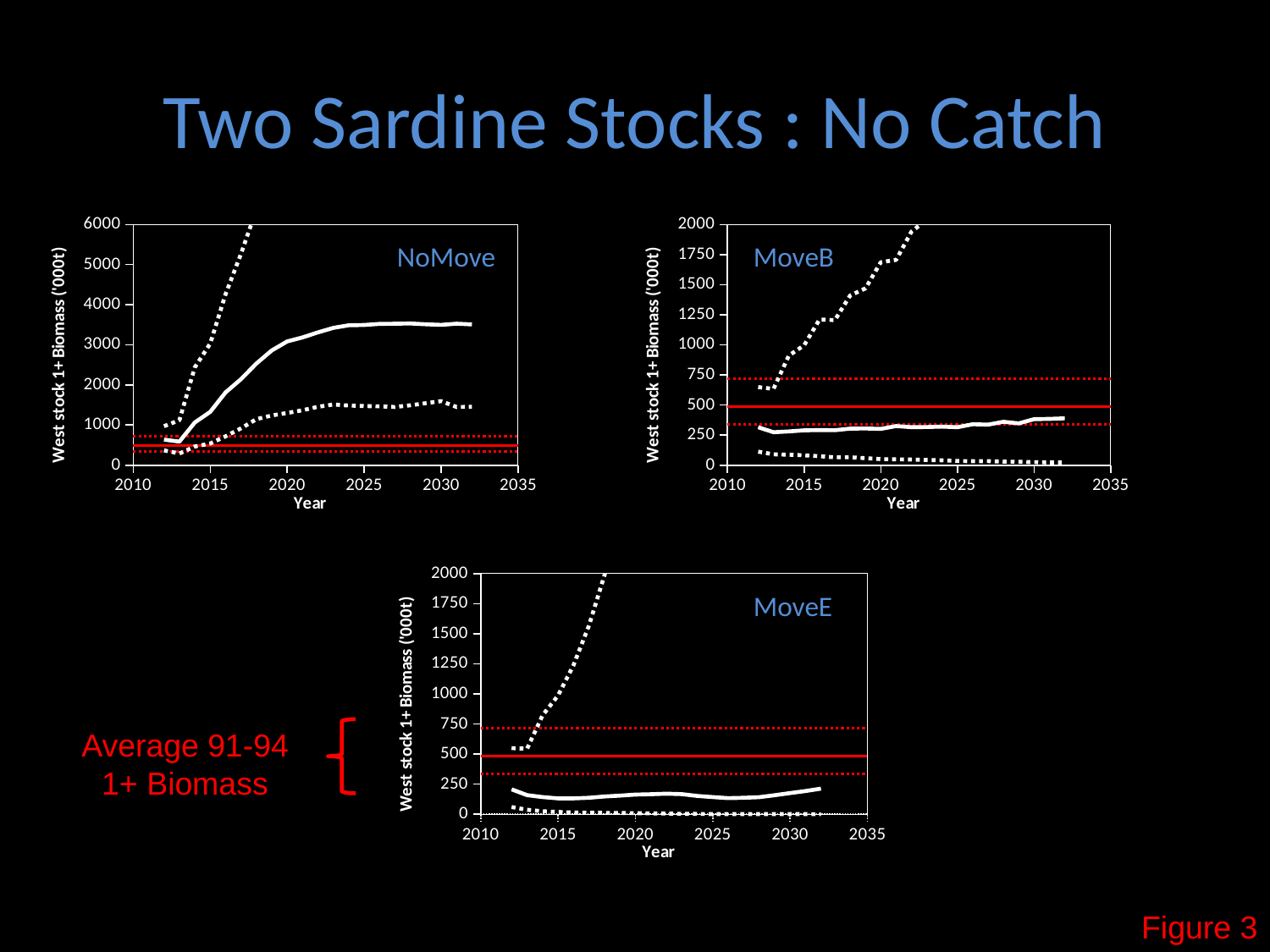
In the MoveB chart, is the value of the solid white line in 2030 greater or less than 500? less In the MoveE chart, is the value of the solid white line in 2020 greater or less than 250? less What is the title of the chart at the top right of the slide? MoveB In the MoveB chart, is the value of the upper dotted white line in 2020 greater or less than 1500? greater What is the y-axis label on the MoveE chart? West stock 1+ Biomass ('000t) What kind of chart is the NoMove chart? line chart How many charts are shown on the slide? 3 What is the highest value shown on the y axis of the NoMove chart? 6000 In the NoMove chart, does the solid white line rise or fall between 2015 and 2025? rise Which is larger in 2030: the solid white line in the NoMove chart or the solid white line in the MoveE chart? NoMove